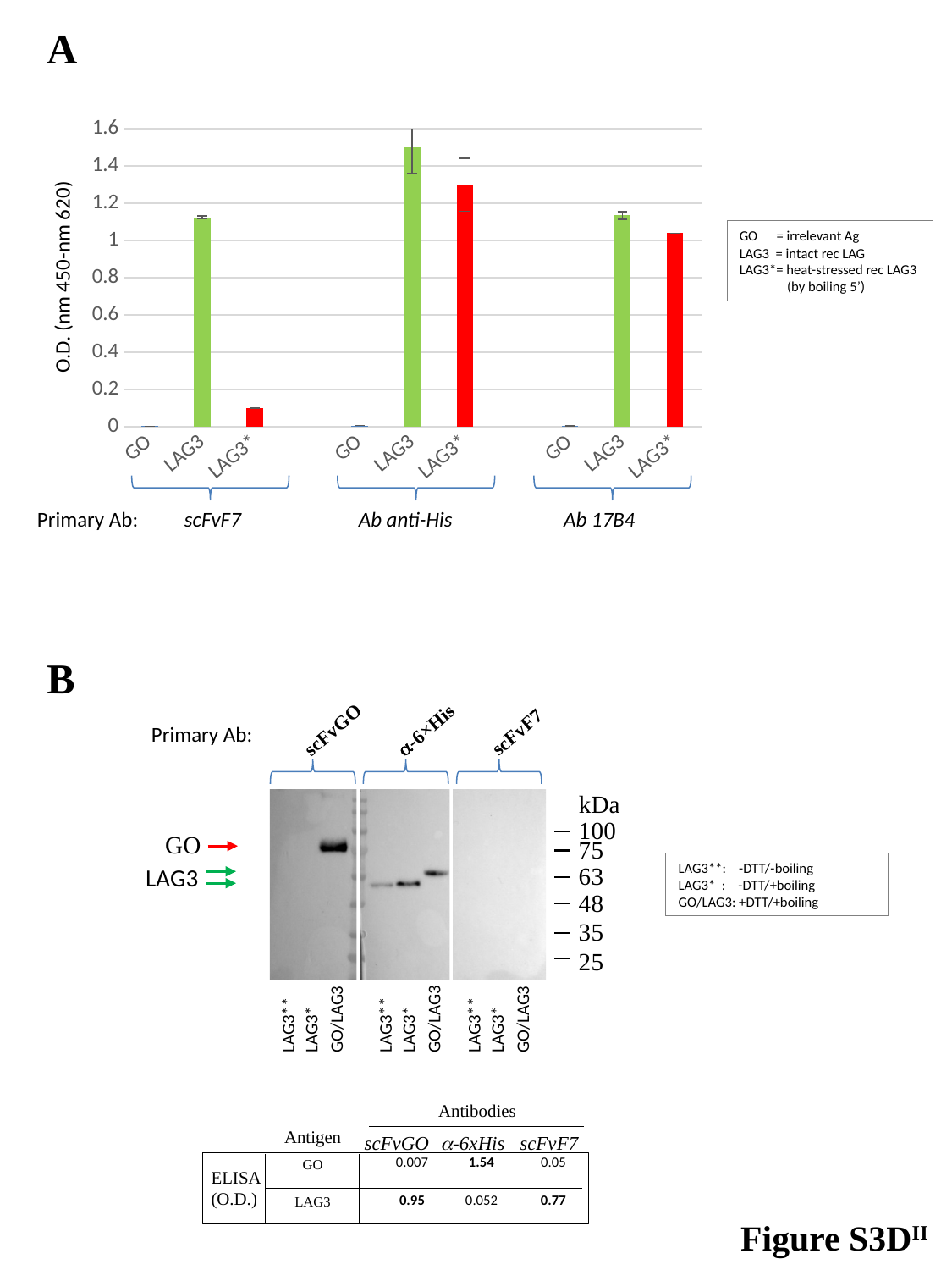
In the panel A bar chart, is the value for LAG3 with scFvF7 greater or less than 1? greater In the panel A bar chart, is the value for LAG3* with scFvF7 greater or less than 0.2? less In the panel A bar chart, which bar is the highest? LAG3 with Ab anti-His In the panel A bar chart, is the value for LAG3* with Ab anti-His greater or less than 1.2? greater In the panel A bar chart, how many bars are plotted in total? 9 In the panel A bar chart, within the scFvF7 group, which antigen has the lowest bar? GO In panel A, what kind of chart is shown? bar chart In the panel A bar chart, how many primary antibody groups are shown on the x axis? 3 In the panel A bar chart, within the scFvF7 group, which is larger: the LAG3 bar or the LAG3* bar? LAG3 What is the y-axis label of the panel A bar chart? O.D. (nm 450-nm 620)